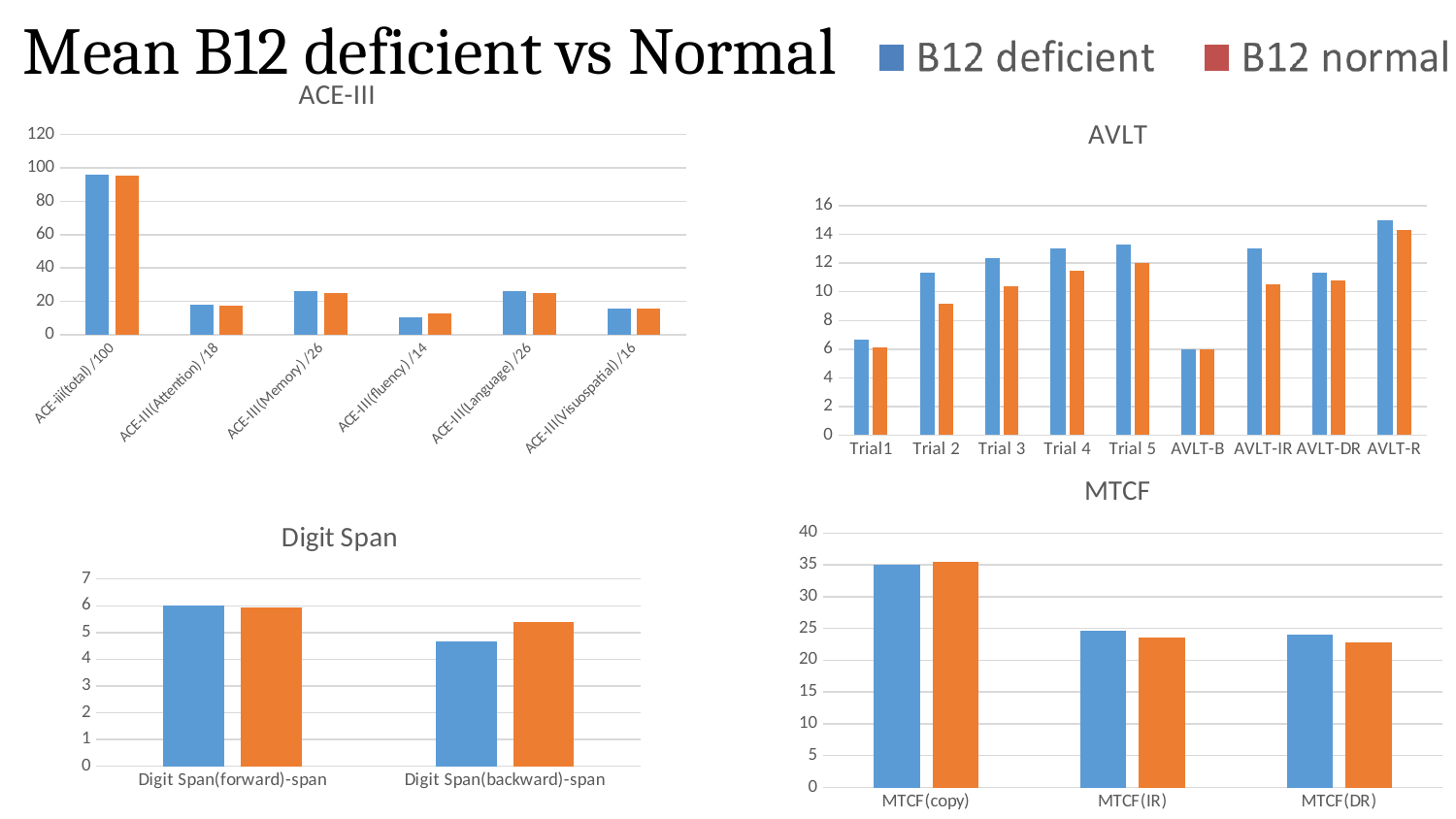
On the AVLT chart, do the values rise or fall from Trial1 to Trial 5? rise On the MTCF chart, is the B12 deficient value for MTCF(copy) greater or less than 30? greater On the Digit Span chart, for Digit Span(backward)-span, which series has the larger value, B12 deficient or B12 normal? B12 normal On the ACE-III chart, which category has the highest values? ACE-iii(total) /100 On the AVLT chart, which category has the highest values? AVLT-R How many categories are shown on the AVLT chart? 9 On the ACE-III chart, which category has the lowest values? ACE-III(fluency) /14 On the ACE-III chart, is the B12 deficient value for ACE-III(total) /100 greater or less than 80? greater How many categories are shown on the MTCF chart? 3 On the AVLT chart, for Trial 2, which series has the larger value, B12 deficient or B12 normal? B12 deficient What kind of chart is the ACE-III chart? bar chart How many series does the legend list? 2